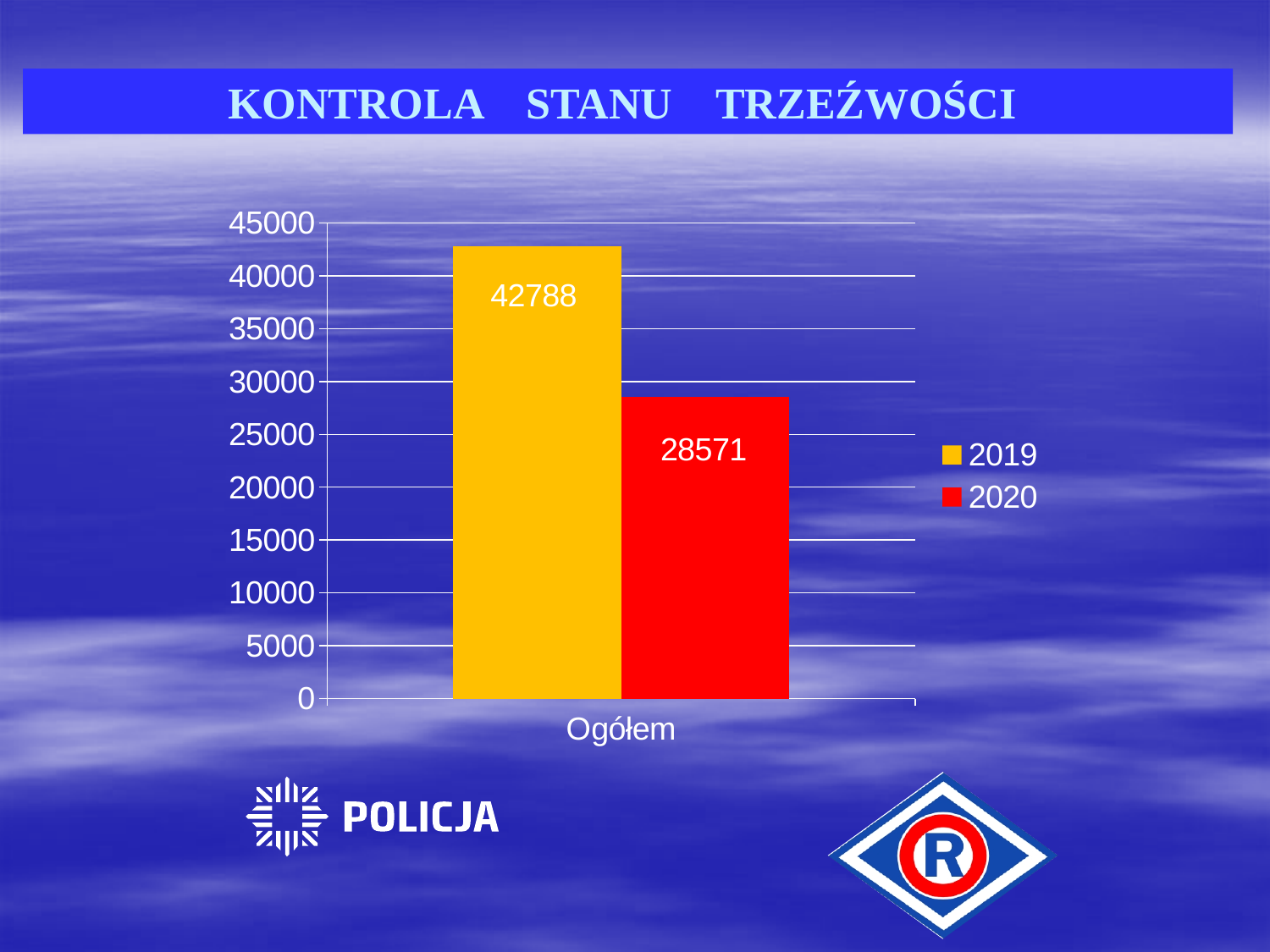
What is the difference between the 2019 and 2020 values for Ogółem? 14217 Is the value for 2019 greater or less than 40000? greater What kind of chart is shown on the slide? bar chart What is the value for 2019 in the Ogółem category? 42788 How many categories are shown on the x axis? 1 How many series does the legend list? 2 What is the value for 2020 in the Ogółem category? 28571 What is the title of the slide above the chart? KONTROLA STANU TRZEŹWOŚCI Is the value for 2020 greater or less than 30000? less What colour is the bar for 2020? red Which year has the higher value for Ogółem, 2019 or 2020? 2019 Which series has the lowest value on the chart? 2020